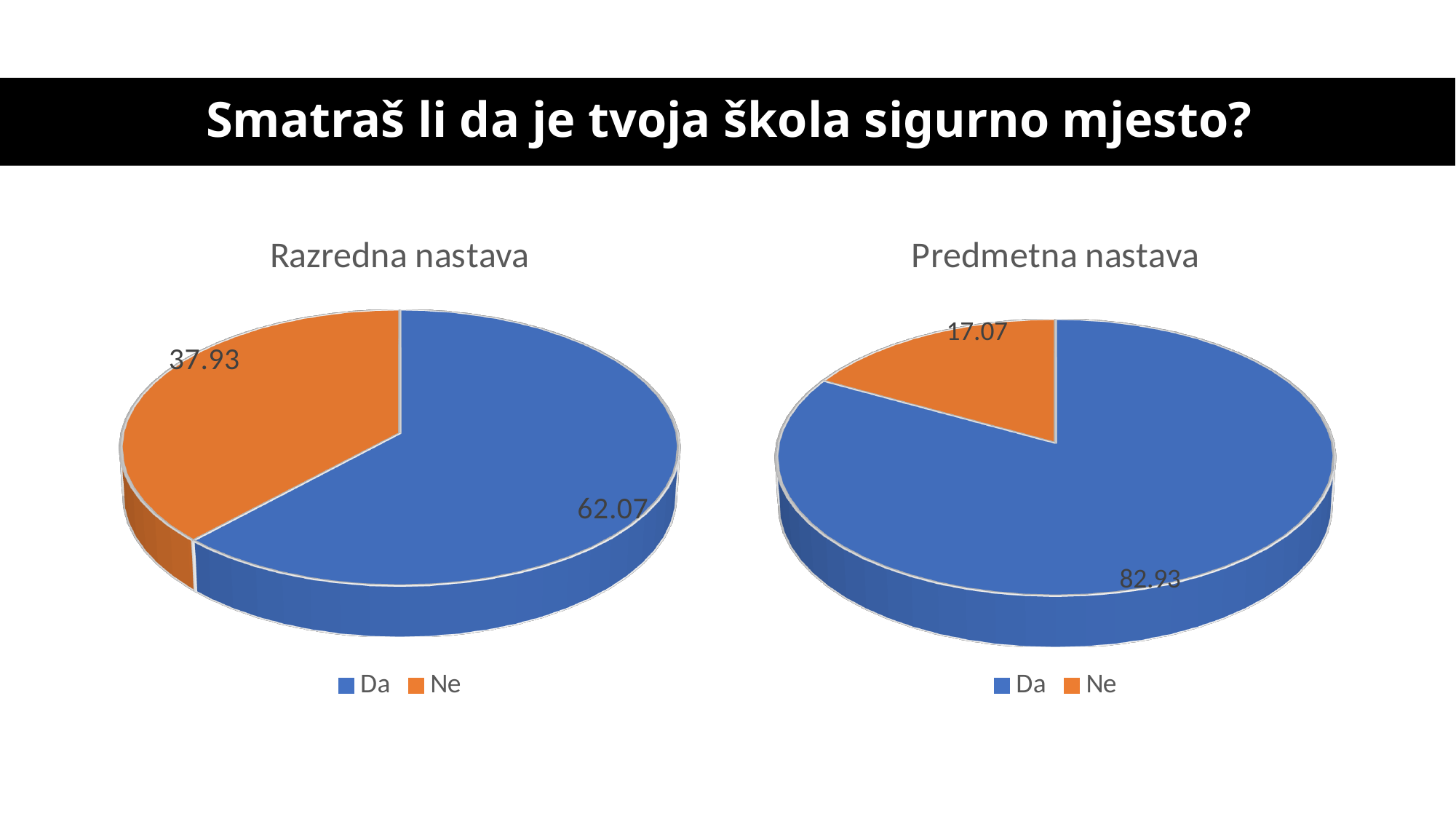
What kind of chart is the 'Razredna nastava' chart? Pie chart In the 'Predmetna nastava' chart, what is the difference between the Da and Ne values? 65.86 In the 'Predmetna nastava' chart, what is the value for Da? 82.93 In the 'Razredna nastava' chart, what is the value for Da? 62.07 In the 'Razredna nastava' chart, what is the difference between the Da and Ne values? 24.14 In the 'Razredna nastava' chart, what is the value for Ne? 37.93 In the 'Predmetna nastava' chart, which slice is the smallest? Ne What colour represents Ne in the 'Predmetna nastava' chart? Orange In the 'Predmetna nastava' chart, what is the value for Ne? 17.07 In the 'Razredna nastava' chart, which slice is the largest? Da Which chart has the larger value for Ne, 'Razredna nastava' or 'Predmetna nastava'? Razredna nastava How many slices does the 'Predmetna nastava' chart have? 2